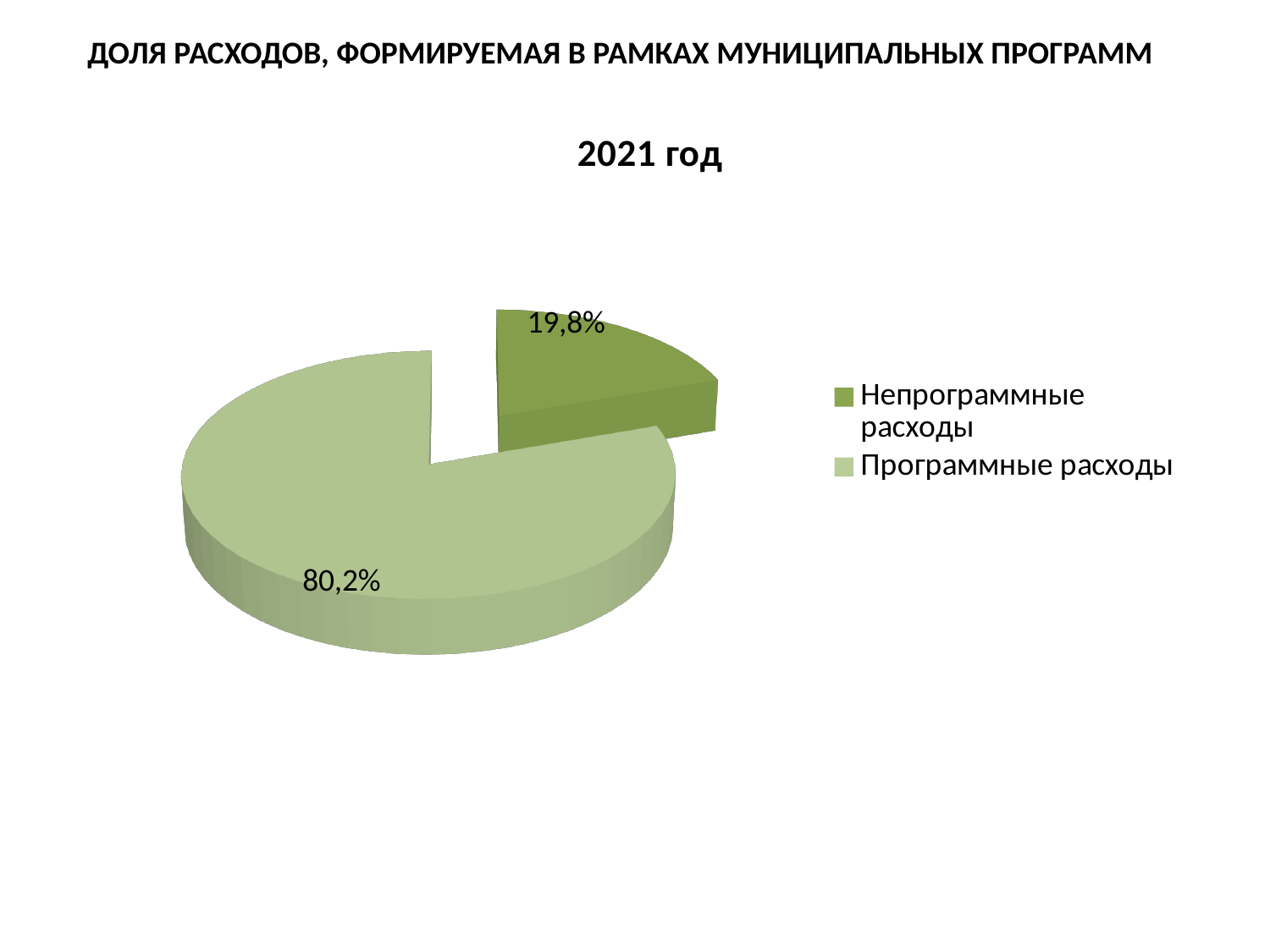
Which category has the largest slice of the pie? Программные расходы Which category has the smallest slice of the pie? Непрограммные расходы How many entries does the legend list? 2 What share of the pie is labelled for Программные расходы? 80,2% Which legend entry is shown in the darker green colour? Непрограммные расходы What kind of chart is shown on the slide? Pie chart What is the total of the two slice labels shown on the pie? 100% What share of the pie is labelled for Непрограммные расходы? 19,8% What is the title of the chart? 2021 год Which is larger: the slice for Непрограммные расходы or the slice for Программные расходы? Программные расходы What is the difference in percentage points between Программные расходы and Непрограммные расходы? 60,4 How many slices does the pie chart have? 2